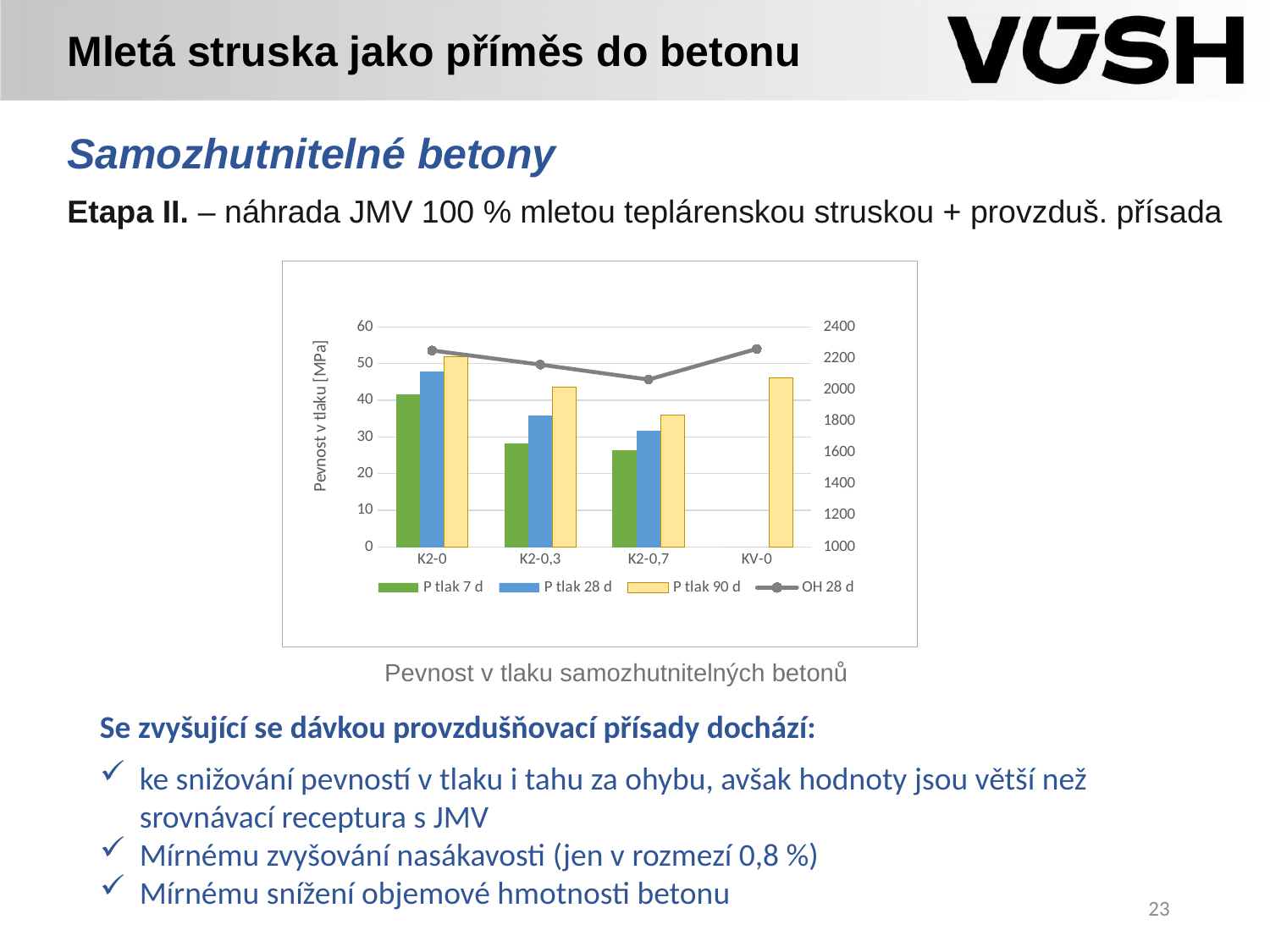
Is the OH 28 d value for K2-0,7 greater or less than 2200? less Which category has the lowest value for the OH 28 d line? K2-0,7 Is the P tlak 90 d value for KV-0 greater or less than 40? greater Do the P tlak 90 d values rise or fall from K2-0 to K2-0,7? fall Which category has the highest value for the P tlak 90 d series? K2-0 How many categories are shown on the x axis of the chart? 4 Is the P tlak 7 d value for K2-0,7 greater or less than 30? less How many series does the chart legend list? 4 What is the title of the left vertical axis of the chart? Pevnost v tlaku [MPa] Which is larger, the P tlak 28 d value for K2-0 or for K2-0,3? K2-0 What kind of chart is shown on the slide? Bar chart combined with a line